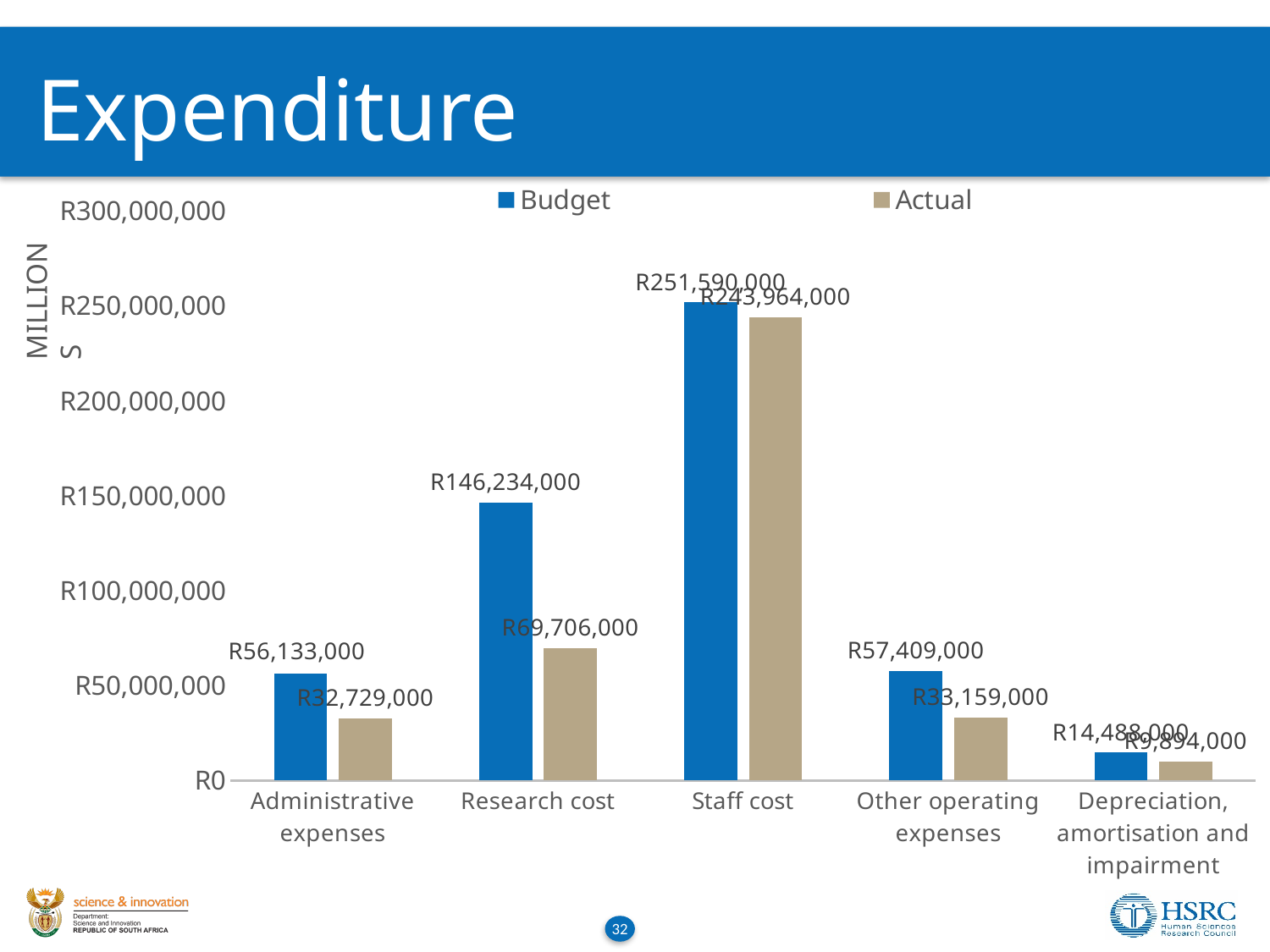
Which is larger: the Budget value for Other operating expenses or the Budget value for Administrative expenses? Other operating expenses How many expenditure categories are shown on the x axis? 5 Which category has the highest Budget value? Staff cost What is the Budget value for Staff cost? R251,590,000 What is the difference between the Budget and Actual values for Research cost? R76,528,000 What is the Actual value for Administrative expenses? R32,729,000 Which category has the lowest Actual value? Depreciation, amortisation and impairment Is the Actual value for Staff cost greater or less than R200,000,000? greater How many series does the legend list? 2 What is the Budget value for Research cost? R146,234,000 What type of chart is shown on the slide? Bar chart What is the Actual value for Other operating expenses? R33,159,000